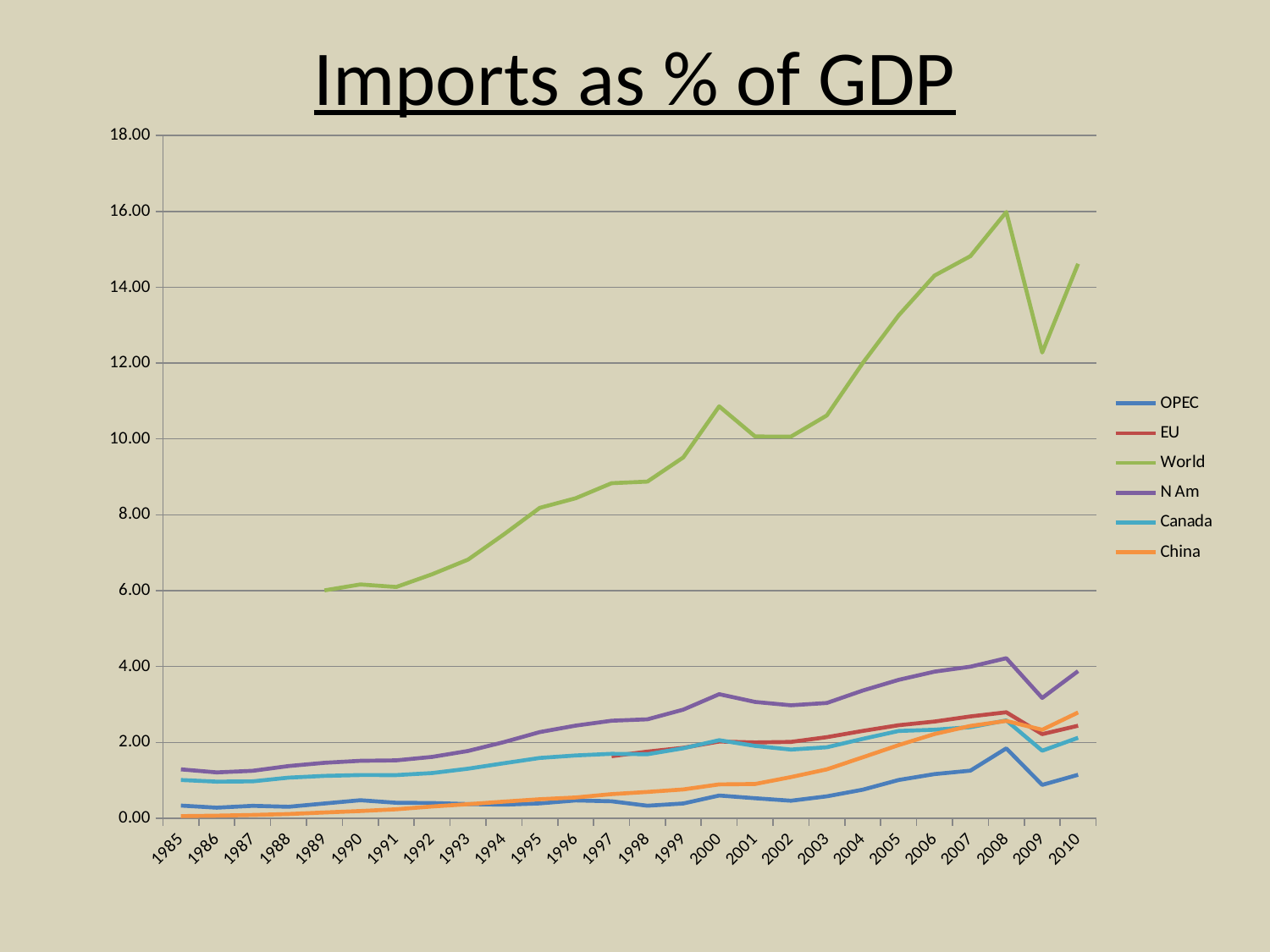
Is the value for N Am in 2008 greater or less than 4.00? greater Does the World series generally rise or fall from 1989 to 2008? rise Which series has the lowest value in 2010? OPEC Is the value for World in 2009 greater or less than 12.00? greater In 2010, which is larger: the value for China or the value for OPEC? China Which series has the highest value in 2008? World Is the value for World in 2000 greater or less than 10.00? greater What kind of chart is shown on the slide? line chart What is the title of the chart? Imports as % of GDP How many series does the legend list? 6 How many years are shown along the x axis? 26